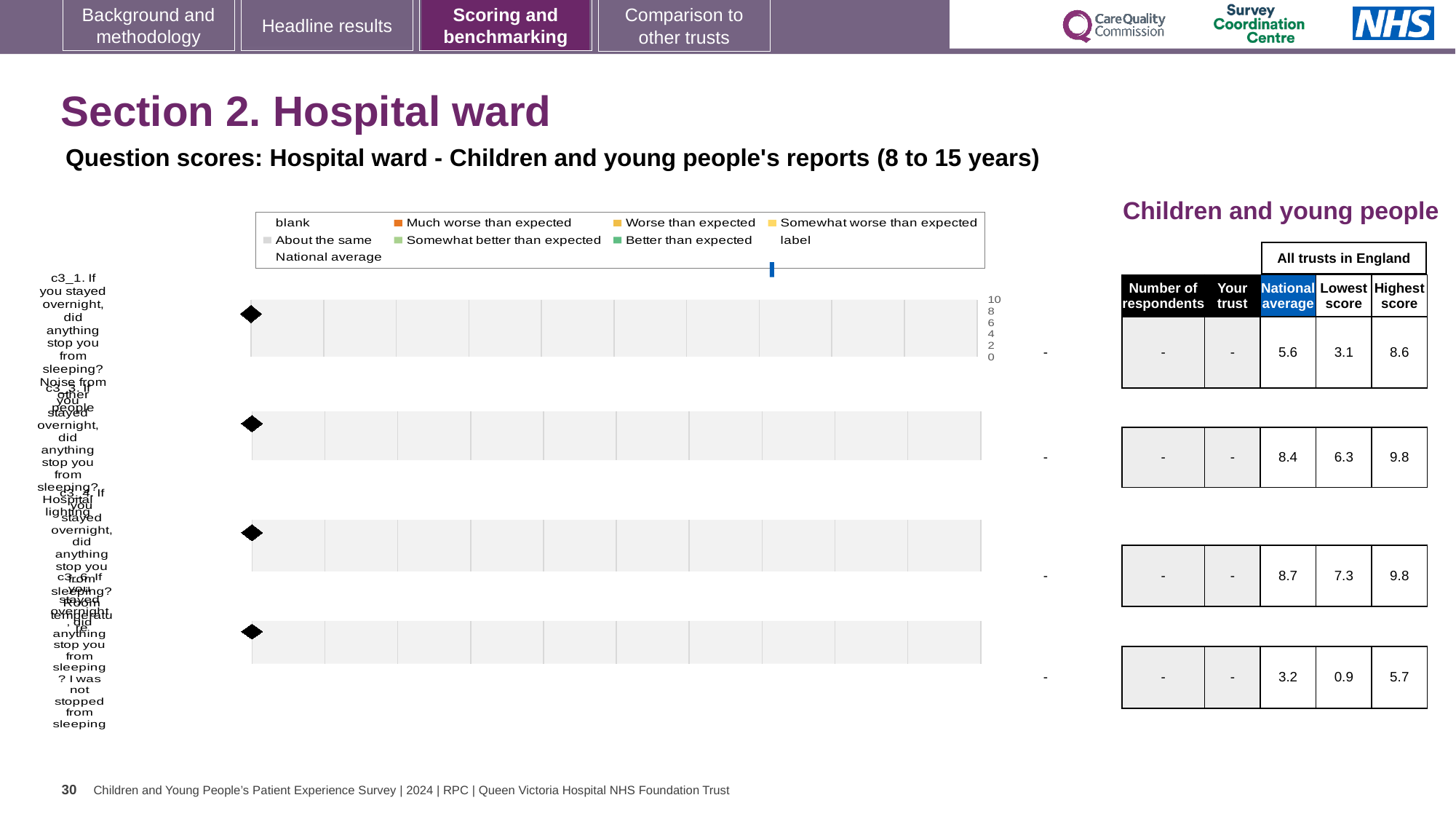
In the table on the right, what is the national average for the first row? 5.6 How many entries does the chart legend list? 9 In the table on the right, what is the difference between the highest and lowest score in the first row? 5.5 How many question rows (bars) does the chart show? 4 Which legend entry is shown with an orange marker? Much worse than expected In the table on the right, what is the lowest score for the bottom row? 0.9 In the table on the right, what is the highest score for the second row? 9.8 In the table on the right, which row has the highest national average? the third row (8.7) What is the maximum value shown on the chart's axis? 10 In the table on the right, is the national average for the second row larger or smaller than that for the third row? smaller What kind of chart is shown on the slide? bar chart In the table on the right, which row has the lowest national average? the bottom row (3.2)